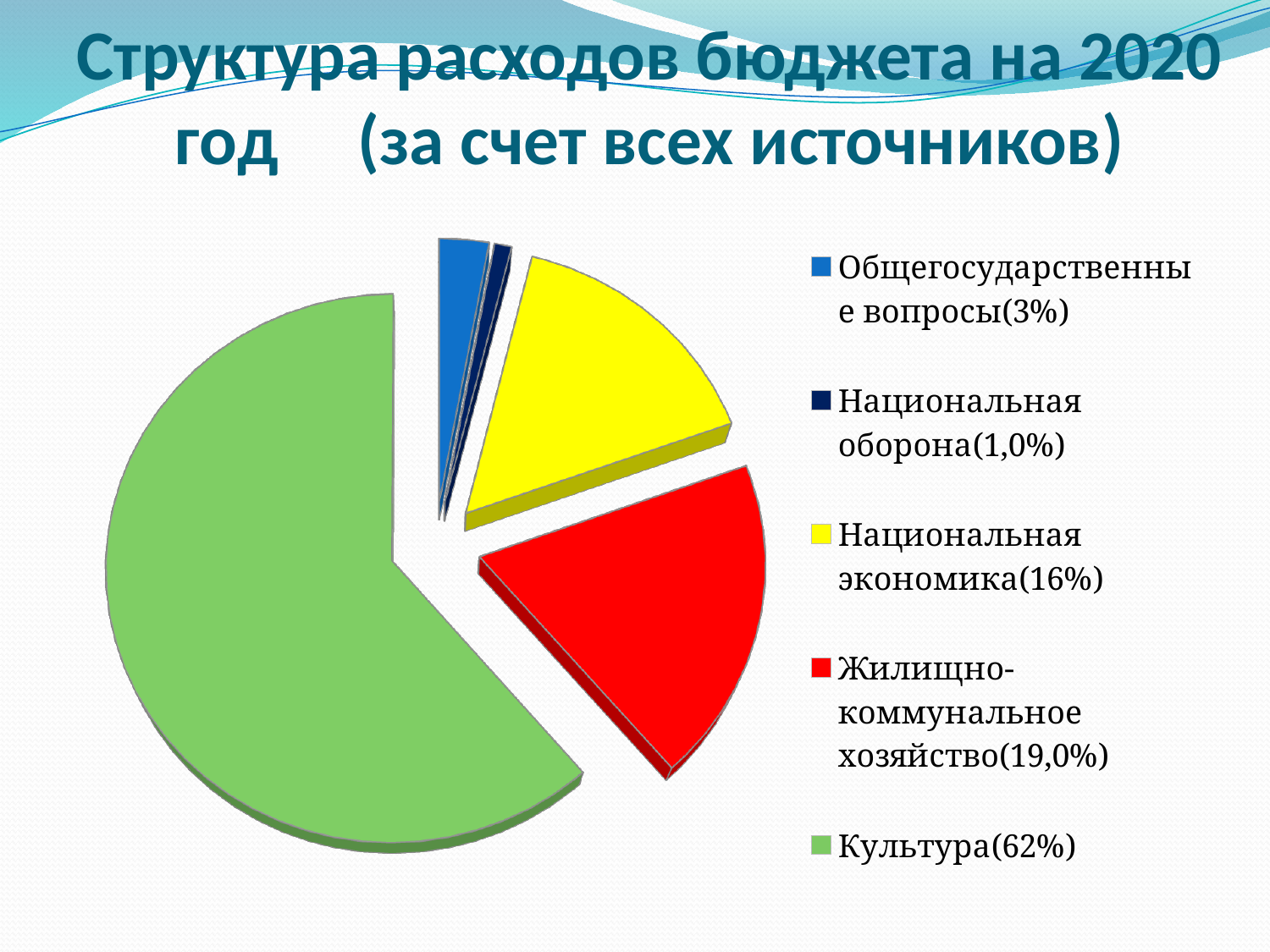
How many slices does the pie chart have? 5 What share is shown for Национальная экономика? 16% How many entries does the legend list? 5 What share is shown for Жилищно-коммунальное хозяйство? 19,0% What share of the budget expenditure goes to Культура? 62% Which category has the largest share of the pie? Культура What kind of chart is shown on the slide? pie chart What is the difference in percentage points between the shares of Культура and Национальная экономика? 46 What share is shown for Национальная оборона? 1,0% What colour is the slice for Общегосударственные вопросы? blue Which category has the smallest share of the pie? Национальная оборона Which is larger: the share for Жилищно-коммунальное хозяйство or for Национальная экономика? Жилищно-коммунальное хозяйство